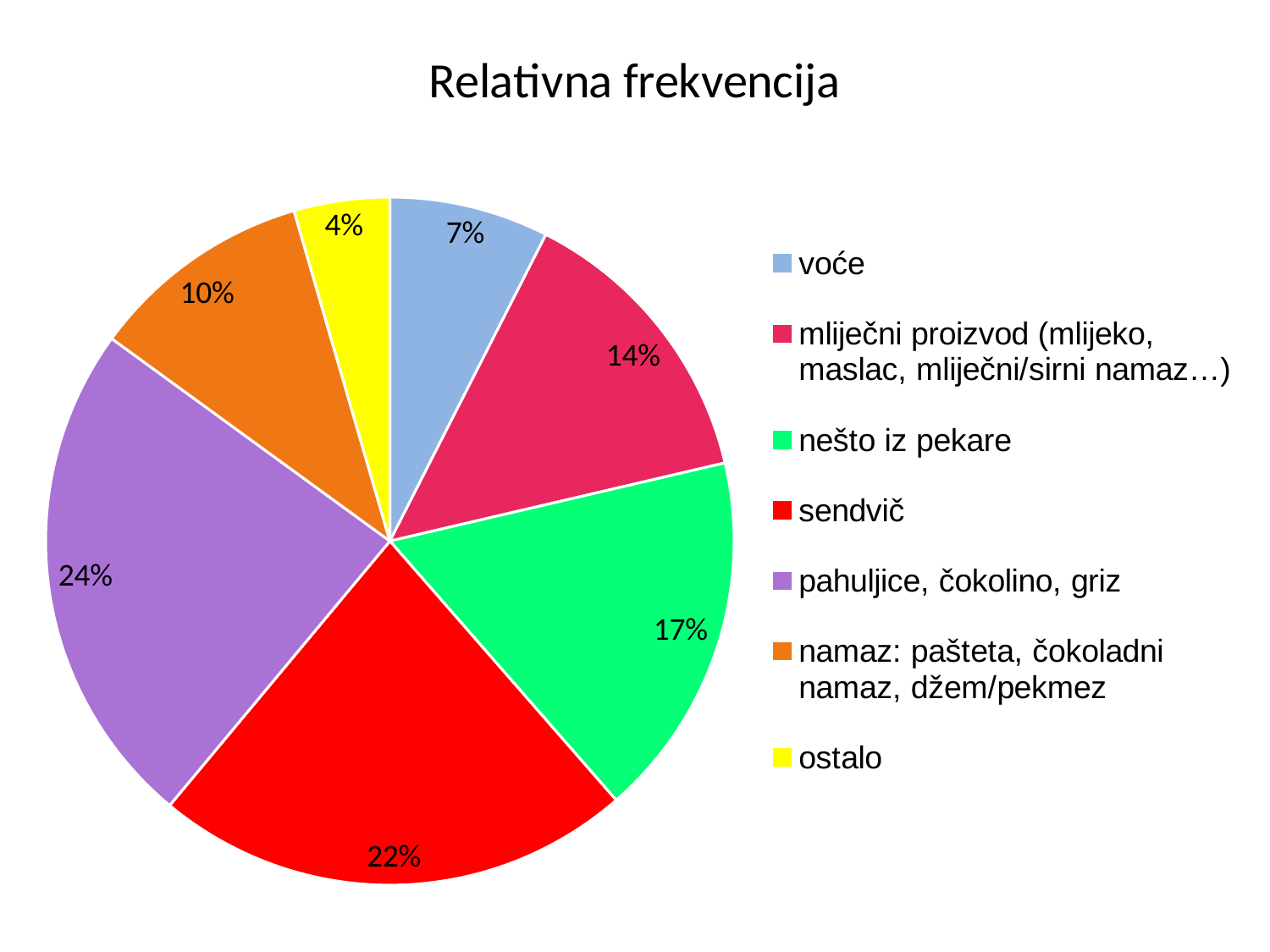
Which category has the smallest slice of the pie? ostalo Which is larger: the slice for "mliječni proizvod (mlijeko, maslac, mliječni/sirni namaz…)" or the slice for "namaz: pašteta, čokoladni namaz, džem/pekmez"? mliječni proizvod (mlijeko, maslac, mliječni/sirni namaz…) How many categories does the pie chart show? 7 What type of chart is shown on the slide? pie chart What share of the pie does "ostalo" have? 4% What share of the pie does "voće" have? 7% What share of the pie does "sendvič" have? 22% What is the title of the chart? Relativna frekvencija What colour is the slice for "sendvič"? red Which category has the largest slice of the pie? pahuljice, čokolino, griz What is the difference in percentage points between "pahuljice, čokolino, griz" and "sendvič"? 2%